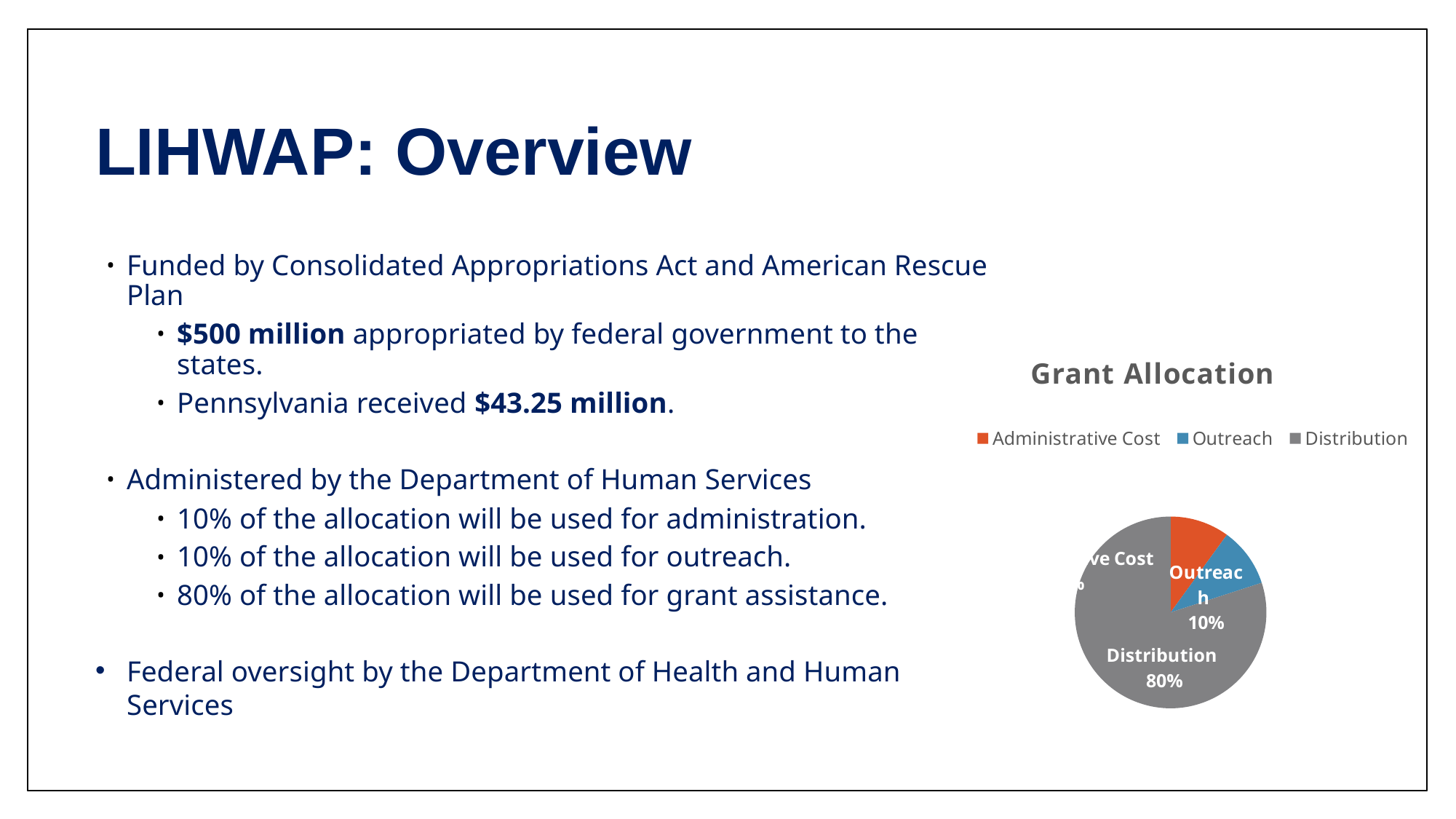
How many slices does the Grant Allocation pie chart have? 3 What percentage of the Grant Allocation pie is labelled for Outreach? 10% How many entries does the legend of the Grant Allocation chart list? 3 What is the title of the chart on the slide? Grant Allocation In the Grant Allocation chart, which is larger: Distribution or Outreach? Distribution What colour is the Distribution slice in the Grant Allocation pie chart? Gray In the Grant Allocation chart, how many percentage points larger is Distribution than Outreach? 70 percentage points What share of the Grant Allocation pie does the Distribution slice take? 80% Which category has the largest slice in the Grant Allocation pie chart? Distribution What kind of chart is shown on the slide? Pie chart What percentage of the Grant Allocation pie is labelled for Distribution? 80%